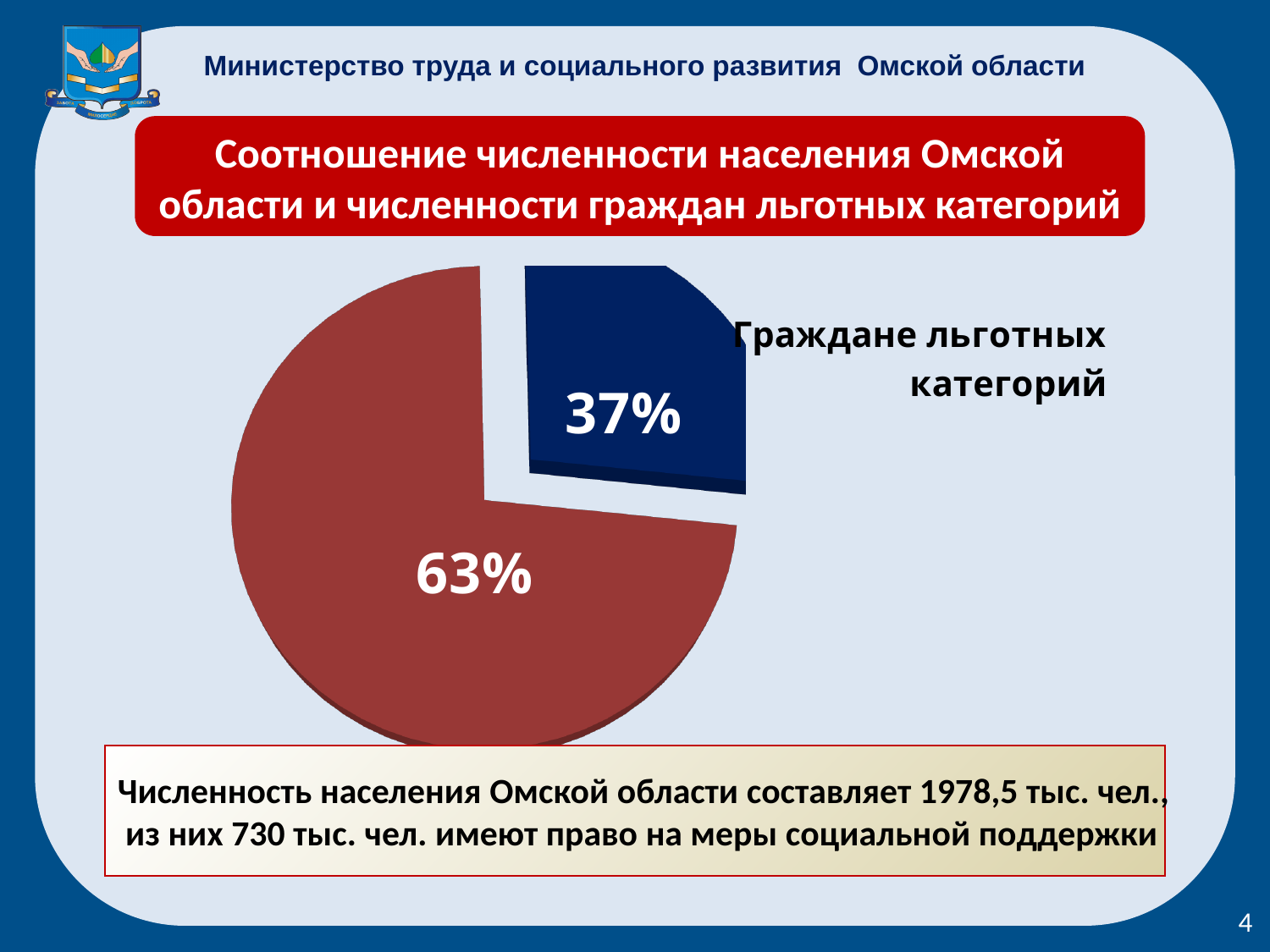
What percentage is printed on the blue slice of the pie chart? 37% What kind of chart is shown on the slide? pie chart Which slice of the pie chart is the smallest? Граждане льготных категорий Is the share for "Граждане льготных категорий" greater or less than 50%? less Which slice of the pie chart is the largest, the red one or the blue one labelled "Граждане льготных категорий"? the red one What is the difference in percentage points between the red slice and the "Граждане льготных категорий" slice? 26 Is the share of the red slice larger or smaller than the share of the blue slice? larger What is the title of the chart on the slide? Соотношение численности населения Омской области и численности граждан льготных категорий How many slices does the pie chart have? 2 What percentage is printed on the red slice of the pie chart? 63% What colour is the slice labelled "Граждане льготных категорий"? blue What share of the pie does the slice labelled "Граждане льготных категорий" represent? 37%